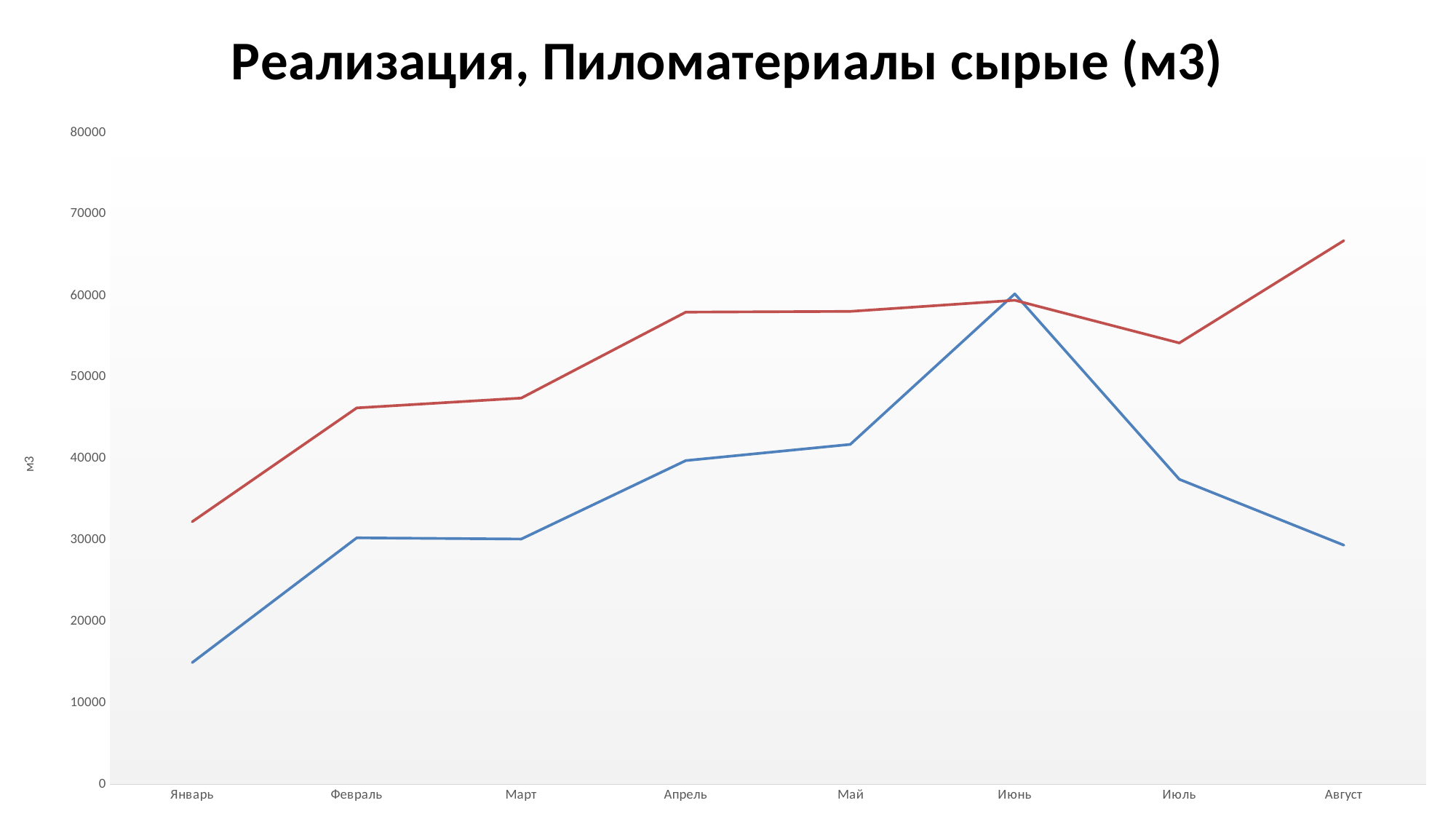
What is the title of the chart? Реализация, Пиломатериалы сырые (м3) Is the value of the blue line for Январь greater or less than 20000? less What kind of chart is shown on the slide? line chart In which month does the blue line reach its highest value? Июнь How many months are shown on the x axis? 8 Which line has the larger value in Январь, the red line or the blue line? the red line In which month does the red line reach its highest value? Август What label is shown on the vertical axis? м3 Is the value of the red line for Август greater or less than 60000? greater In which month is the blue line at its lowest value? Январь How many lines are plotted on the chart? 2 Does the blue line rise or fall from Июнь to Август? fall